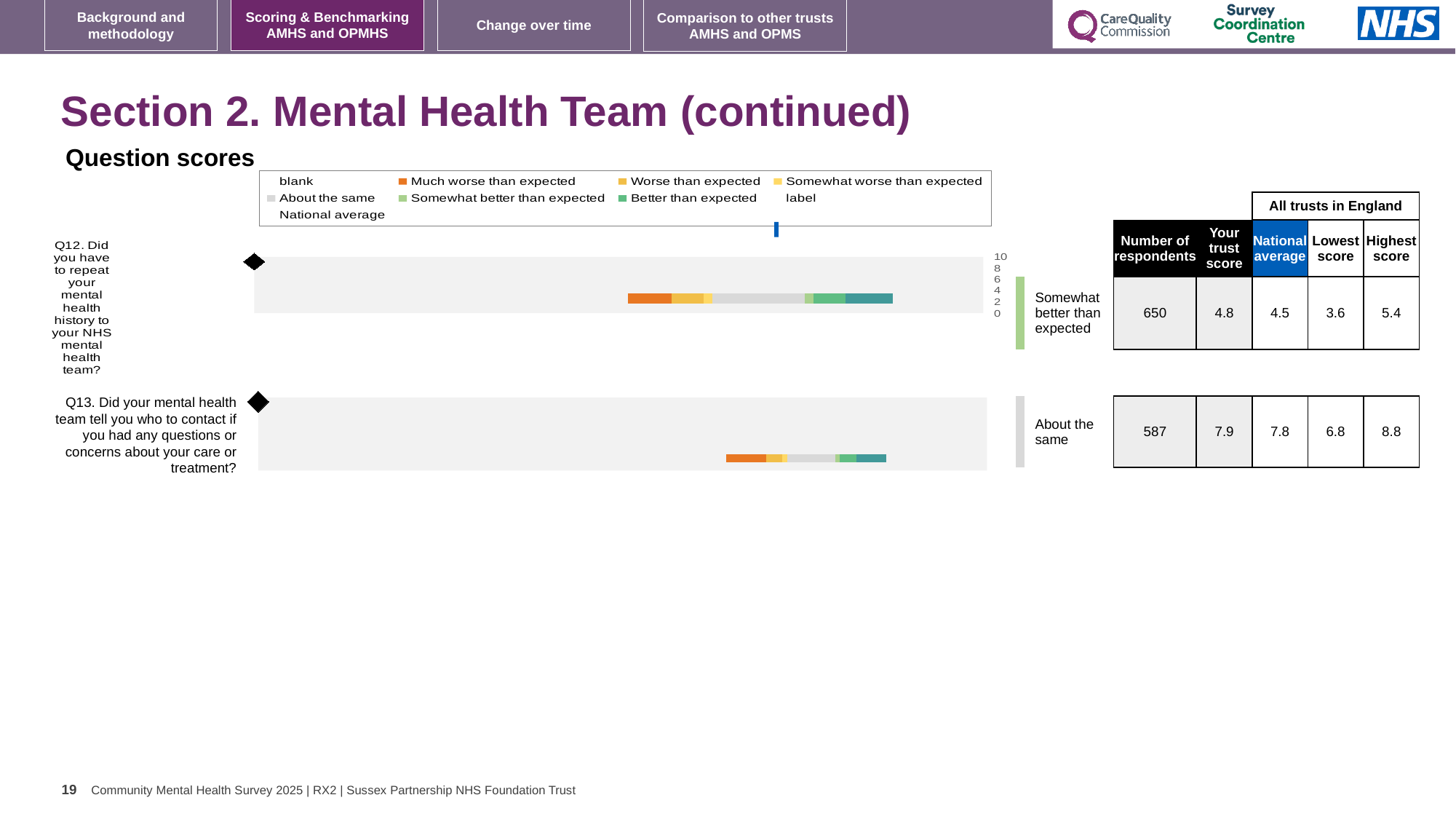
What is the lowest score among all trusts in England for Q12? 3.6 What is the number of respondents for Q12? 650 Which legend entry is shown in orange? Much worse than expected How many questions (Q12 and Q13) have a score bar plotted on the slide? 2 What kind of chart is used to show the question scores for Q12 and Q13? bar chart What is the highest score among all trusts in England for Q13? 8.8 What is the difference between your trust score and the national average for Q12? 0.3 What is the difference between the highest score and the lowest score for Q13? 2.0 What benchmark category is shown next to the Q13 bar? About the same What is the national average for Q13? 7.8 What is your trust score for Q12? 4.8 For Q12, which is larger: your trust score or the national average? your trust score